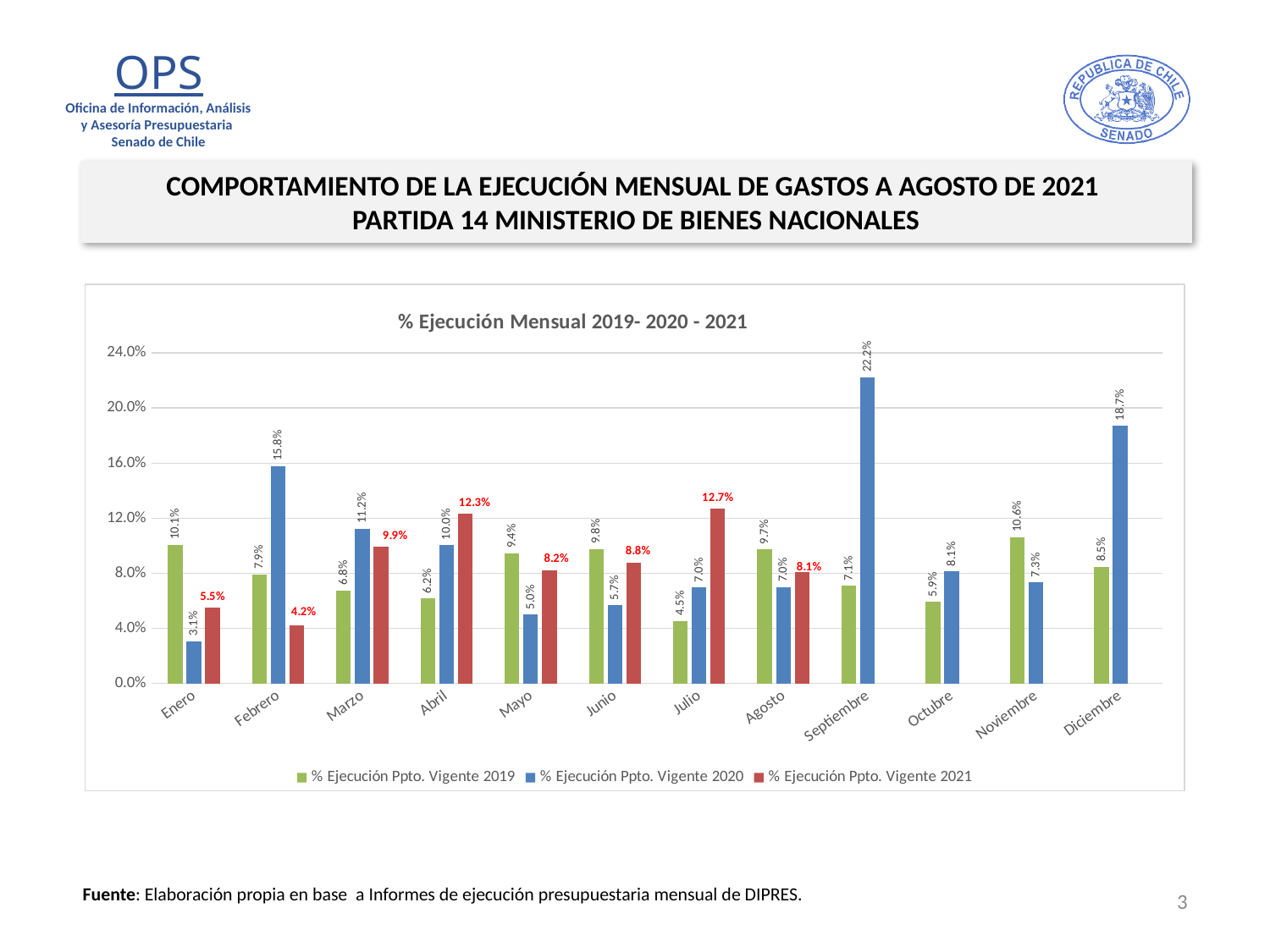
In which month is the % Ejecución Ppto. Vigente 2021 series lowest? Febrero What is the difference between the 2021 and 2020 values in Abril? 2.3% In which month does the % Ejecución Ppto. Vigente 2020 series reach its highest value? Septiembre What is the value for % Ejecución Ppto. Vigente 2019 in Noviembre? 10.6% How many series does the legend list? 3 What is the value for % Ejecución Ppto. Vigente 2020 in Febrero? 15.8% What is the title of the chart? % Ejecución Mensual 2019- 2020 - 2021 What kind of chart is shown on the slide? Bar chart What is the value for % Ejecución Ppto. Vigente 2020 in Diciembre? 18.7% What is the value for % Ejecución Ppto. Vigente 2021 in Julio? 12.7% Which is larger in Enero: the 2019 value or the 2021 value? 2019 (10.1%) How many months are shown on the x axis? 12